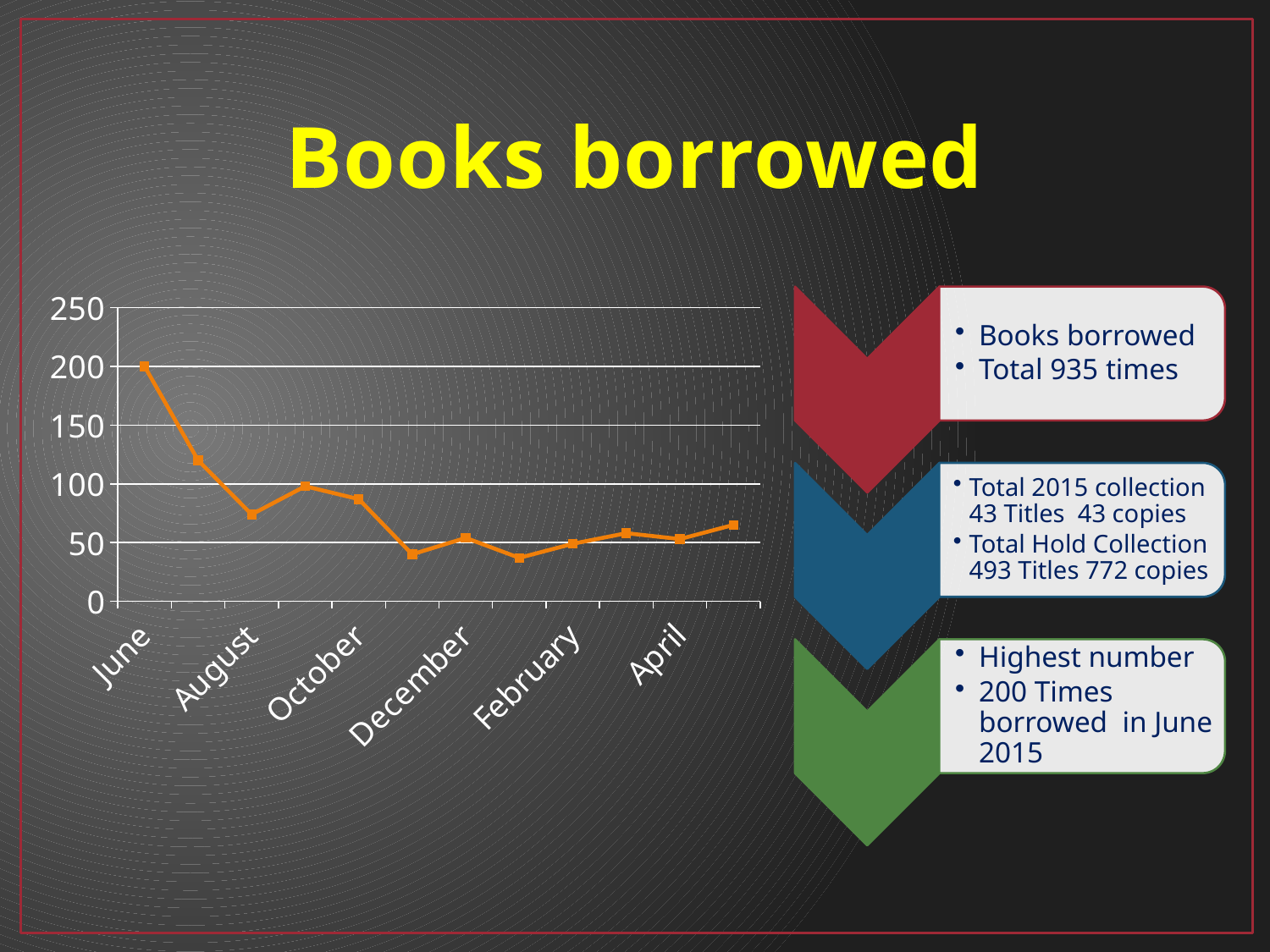
How many month labels are shown on the x axis? 6 Which is larger, the value for June or the value for August? June What kind of chart is shown on the slide? line chart Do the values generally rise or fall from June to December? fall Is the value for August greater or less than 100? less Is the value for June greater or less than 150? greater What is the title of the slide containing the chart? Books borrowed Is the value for December greater or less than 100? less Which month has the highest number of books borrowed? June What is the value for June? 200 Which is larger, the value for October or the value for December? October